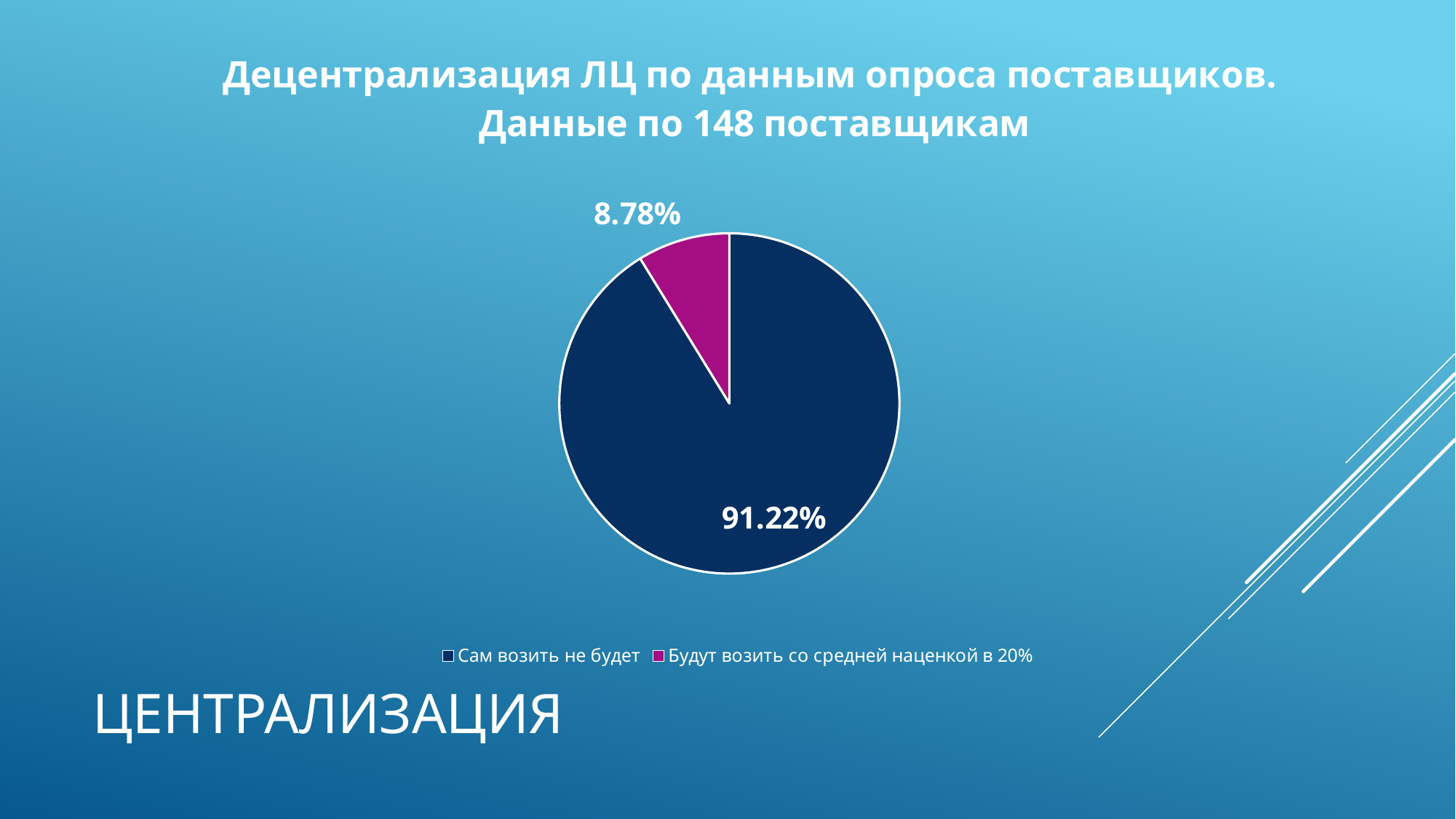
What is the title of the chart? Децентрализация ЛЦ по данным опроса поставщиков. Данные по 148 поставщикам How many slices does the pie chart have? 2 What kind of chart is shown on the slide? pie chart Which slice is the smallest? Будут возить со средней наценкой в 20% Which slice is the largest? Сам возить не будет How many suppliers does the chart title say the data covers? 148 What share of the pie does "Будут возить со средней наценкой в 20%" take? 8.78% What colour is the slice for "Будут возить со средней наценкой в 20%"? magenta (purple) What share of the pie does "Сам возить не будет" take? 91.22% What is the difference between the shares of "Сам возить не будет" and "Будут возить со средней наценкой в 20%"? 82.44% Which is larger: the share for "Сам возить не будет" or for "Будут возить со средней наценкой в 20%"? Сам возить не будет How many entries does the legend list? 2